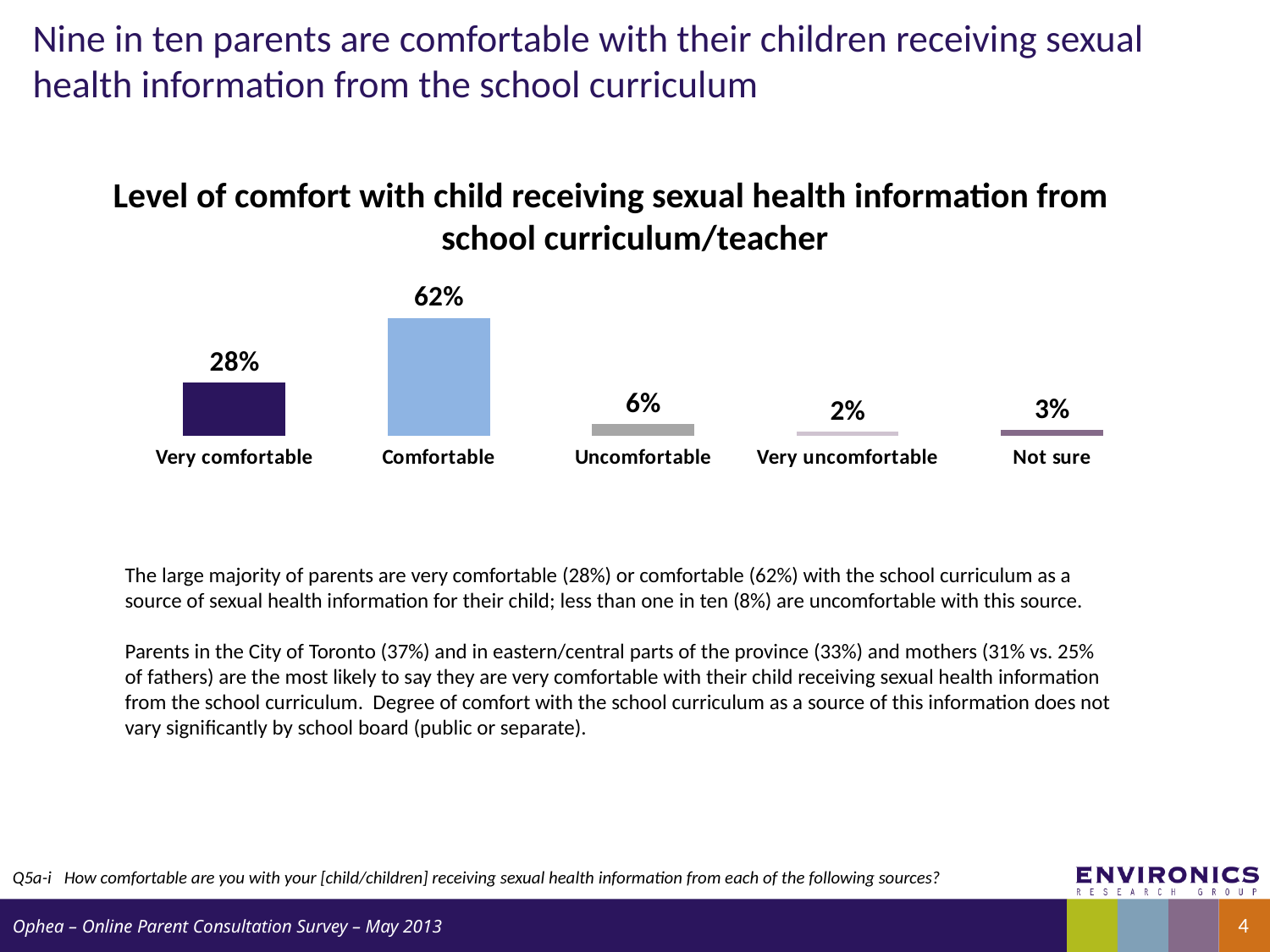
What is the value shown for "Very comfortable"? 28% What is the title of the chart? Level of comfort with child receiving sexual health information from school curriculum/teacher Which is larger, the value for "Uncomfortable" or the value for "Not sure"? Uncomfortable What percentage of parents answered "Not sure"? 3% What is the difference between the "Comfortable" and "Very comfortable" values? 34% What is the value for "Very uncomfortable"? 2% How many categories are shown in the chart? 5 Which category has the lowest value in the chart? Very uncomfortable Which category has the highest value in the chart? Comfortable What type of chart is shown on the slide? Bar chart What percentage of parents are "Comfortable" with their child receiving sexual health information from the school curriculum/teacher? 62% What is the combined value of "Very comfortable" and "Comfortable"? 90%